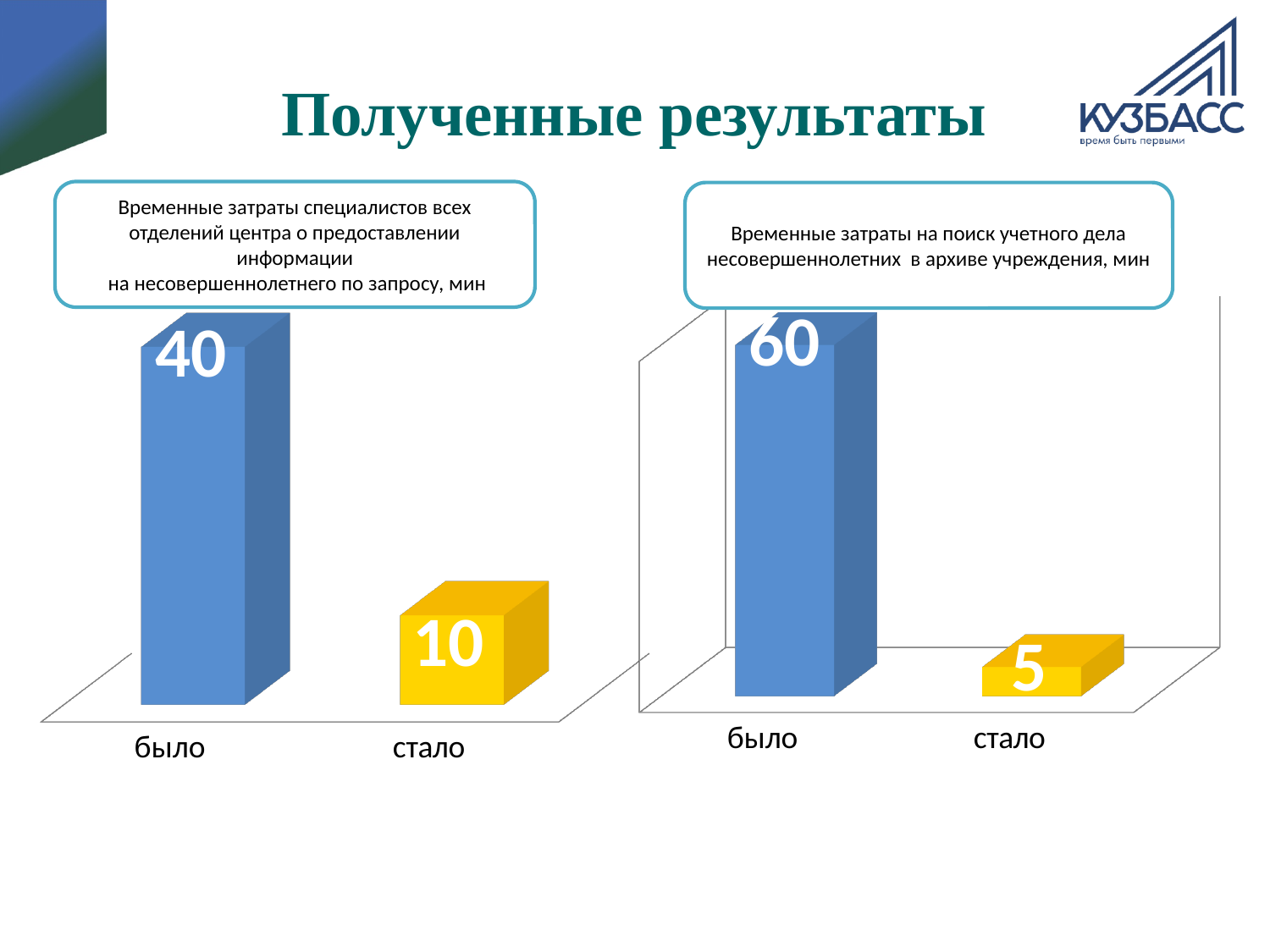
In the left chart, which category has the highest value? было In the right chart, what is the value for "было"? 60 In the left chart, what is the difference between the values for "было" and "стало"? 30 How many categories does the left chart show? 2 In the right chart, what is the value for "стало"? 5 In the left chart, what is the value for "было"? 40 In the right chart, what is the difference between the values for "было" and "стало"? 55 In the right chart, which is larger: the value for "было" or the value for "стало"? было In the left chart, do the values rise or fall from "было" to "стало"? fall What type of chart is the right chart? bar chart In the right chart, which category has the lowest value? стало In the left chart, what is the value for "стало"? 10